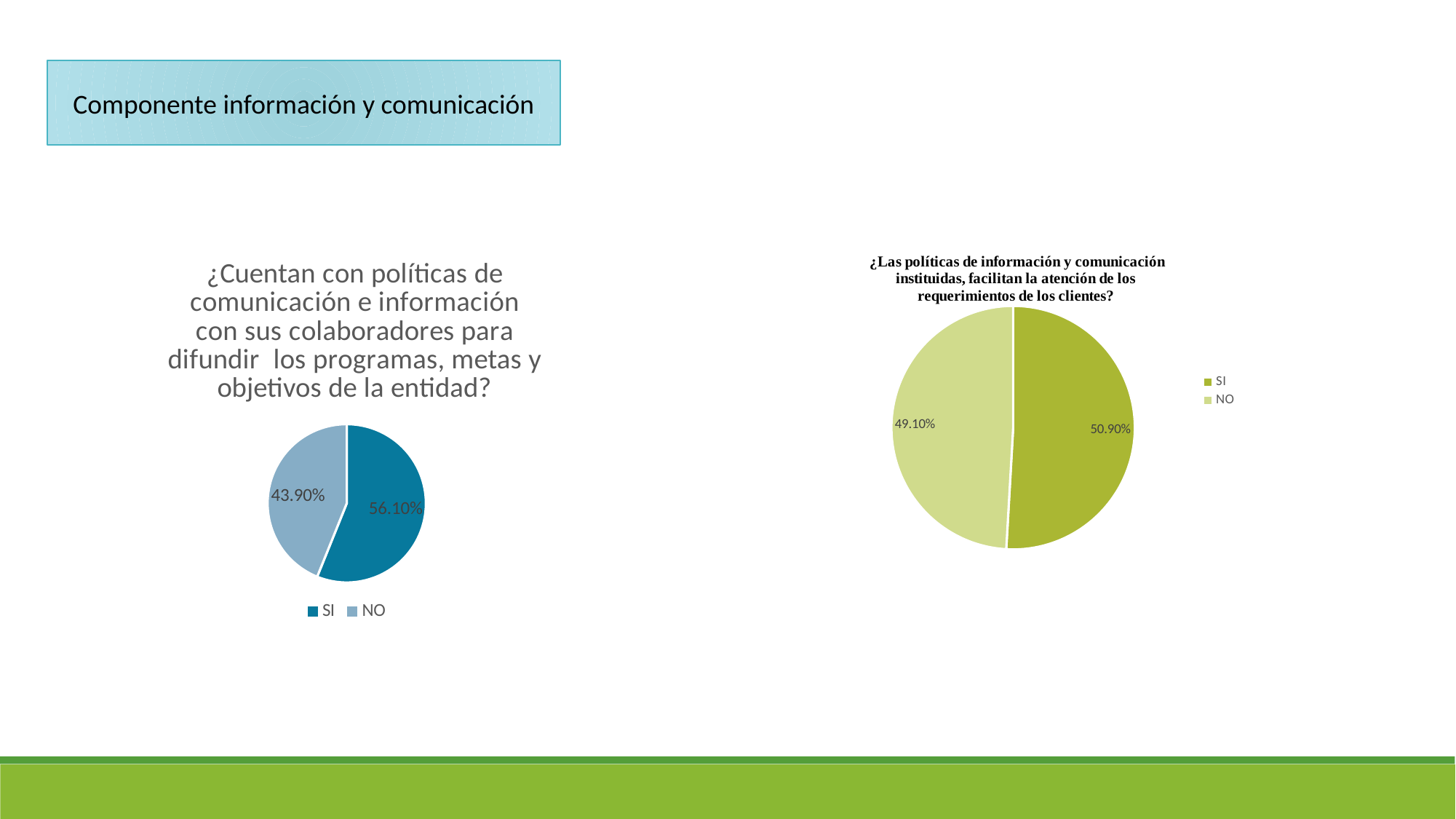
In the right pie chart, what percentage is shown for NO? 49.10% In the right pie chart, which is larger, SI or NO? SI How many slices does the right pie chart have? 2 In the right pie chart, which category has the smallest slice? NO In the right pie chart, what is the difference between the SI and NO percentages? 1.80% In the left pie chart, what percentage is shown for SI? 56.10% In the left pie chart, what percentage is shown for NO? 43.90% In the left pie chart, which category has the largest slice? SI In the right pie chart, what percentage is shown for SI? 50.90% In the left pie chart, what is the difference between the SI and NO percentages? 12.20% How many entries does the legend of the left pie chart list? 2 What type of chart is the left chart? Pie chart